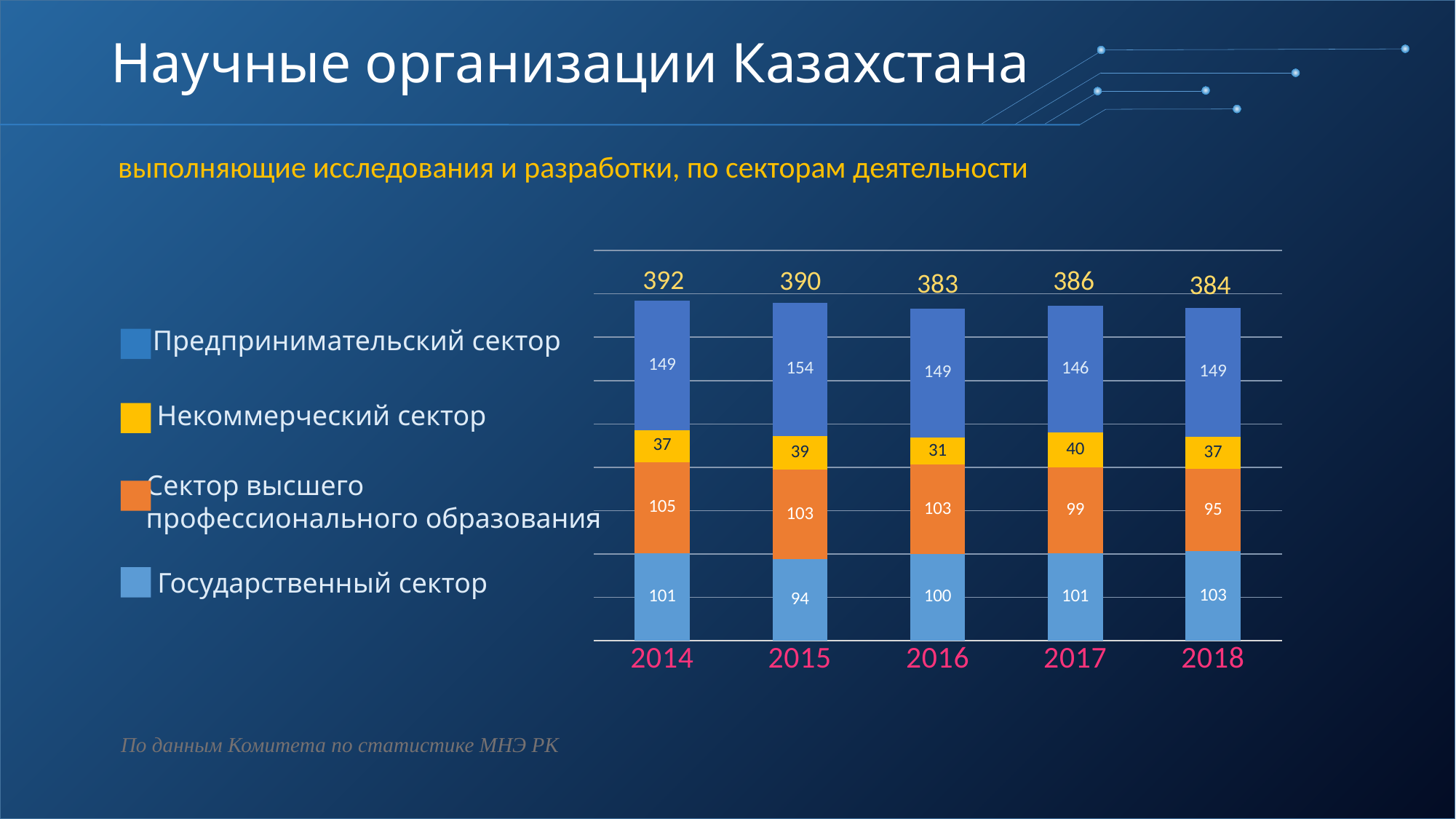
How many years are shown on the x axis? 5 What is the value for Государственный сектор in 2016? 100 What is the total of the stacked bar for 2014? 392 What is the value for Предпринимательский сектор in 2015? 154 What is the value for Сектор высшего профессионального образования in 2018? 95 Which is larger in 2015: Государственный сектор or Сектор высшего профессионального образования? Сектор высшего профессионального образования What is the difference between the Сектор высшего профессионального образования values in 2014 and 2018? 10 In which year is the total of the stacked bar lowest? 2016 What type of chart is shown on the slide? stacked bar chart In which year is the value for Некоммерческий сектор lowest? 2016 How many series does the legend list? 4 What is the value for Некоммерческий сектор in 2017? 40